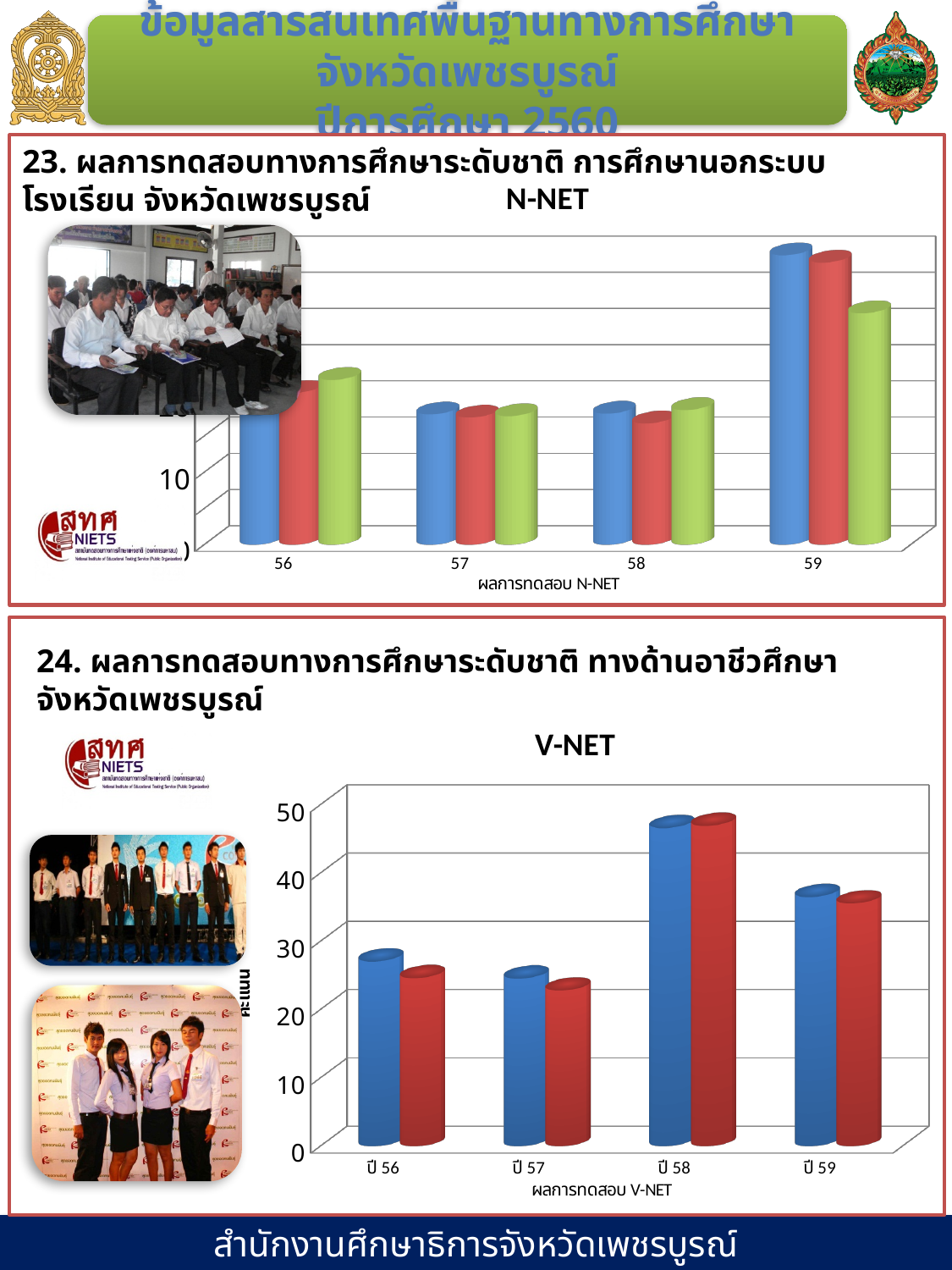
In the V-NET chart, which category has the highest bars? ปี 58 How many categories are shown on the x axis of the N-NET chart? 4 What type of chart is the V-NET chart? bar chart In the V-NET chart, is the blue bar for ปี 57 greater or less than 30? less How many categories are shown on the x axis of the V-NET chart? 4 What is the title of the bottom chart? V-NET What is the title of the top chart? N-NET In the V-NET chart, which category has the lowest bars? ปี 57 In the V-NET chart, is the blue bar for ปี 58 greater or less than 40? greater In the V-NET chart, is the red bar for ปี 59 greater or less than 30? greater In the V-NET chart, which is larger: the blue bar for ปี 58 or the blue bar for ปี 56? ปี 58 In the N-NET chart, which category has the highest bars? 59